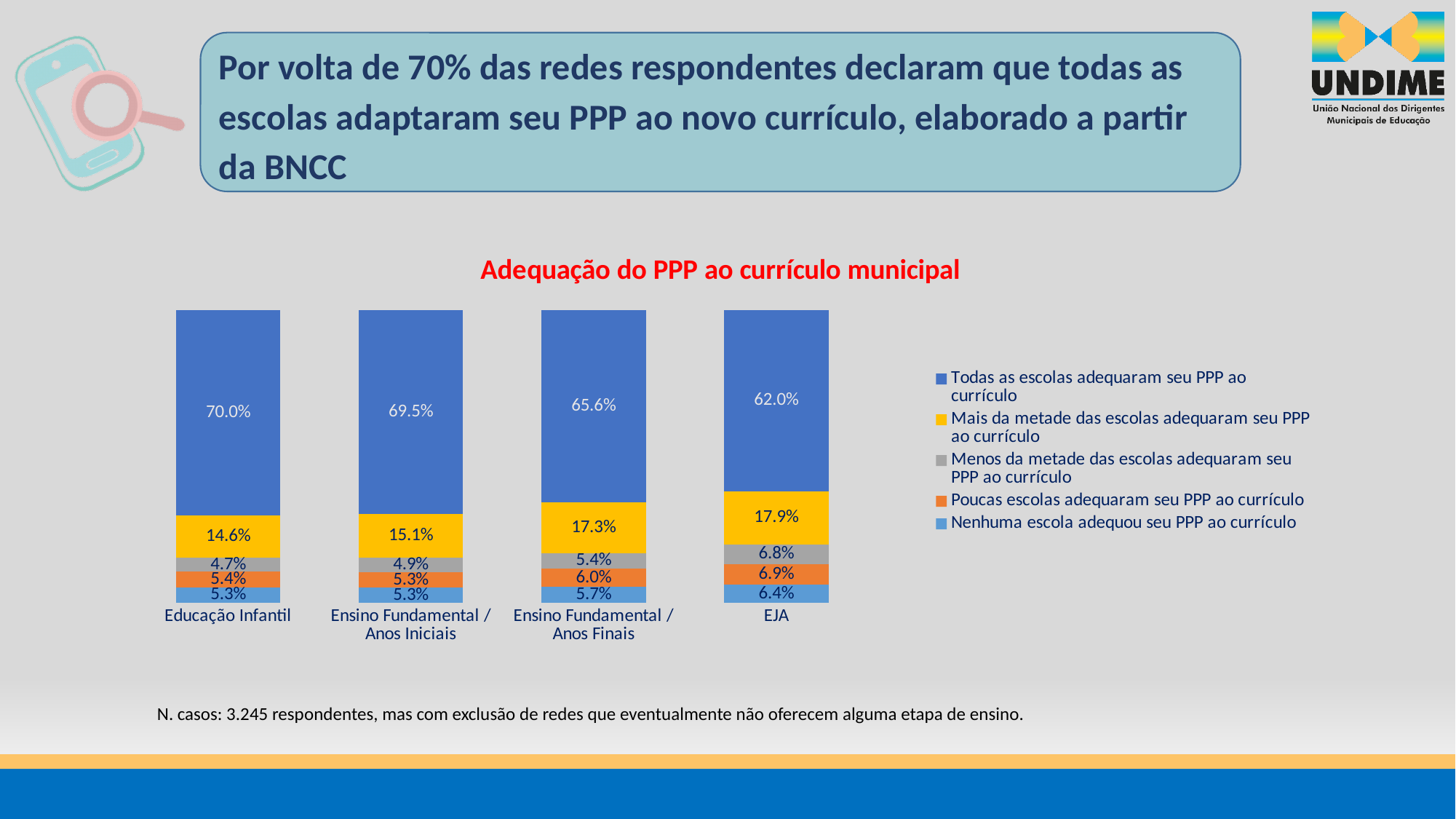
Which category has the lowest value for "Todas as escolas adequaram seu PPP ao currículo"? EJA What is the difference between the "Todas as escolas adequaram seu PPP ao currículo" values for Educação Infantil and EJA? 8.0 percentage points What is the value for "Nenhuma escola adequou seu PPP ao currículo" in the Educação Infantil bar? 5.3% Do the values for "Todas as escolas adequaram seu PPP ao currículo" rise or fall from left to right across the categories? Fall How many categories are shown on the x axis of the chart? 4 What kind of chart is shown on the slide? Stacked bar chart What is the value for "Todas as escolas adequaram seu PPP ao currículo" in the EJA bar? 62.0% Which category has the highest value for "Todas as escolas adequaram seu PPP ao currículo"? Educação Infantil What is the title of the chart? Adequação do PPP ao currículo municipal What is the value for "Mais da metade das escolas adequaram seu PPP ao currículo" in the Ensino Fundamental / Anos Finais bar? 17.3% How many series does the legend list? 5 Which has the larger value for "Poucas escolas adequaram seu PPP ao currículo": EJA or Ensino Fundamental / Anos Finais? EJA